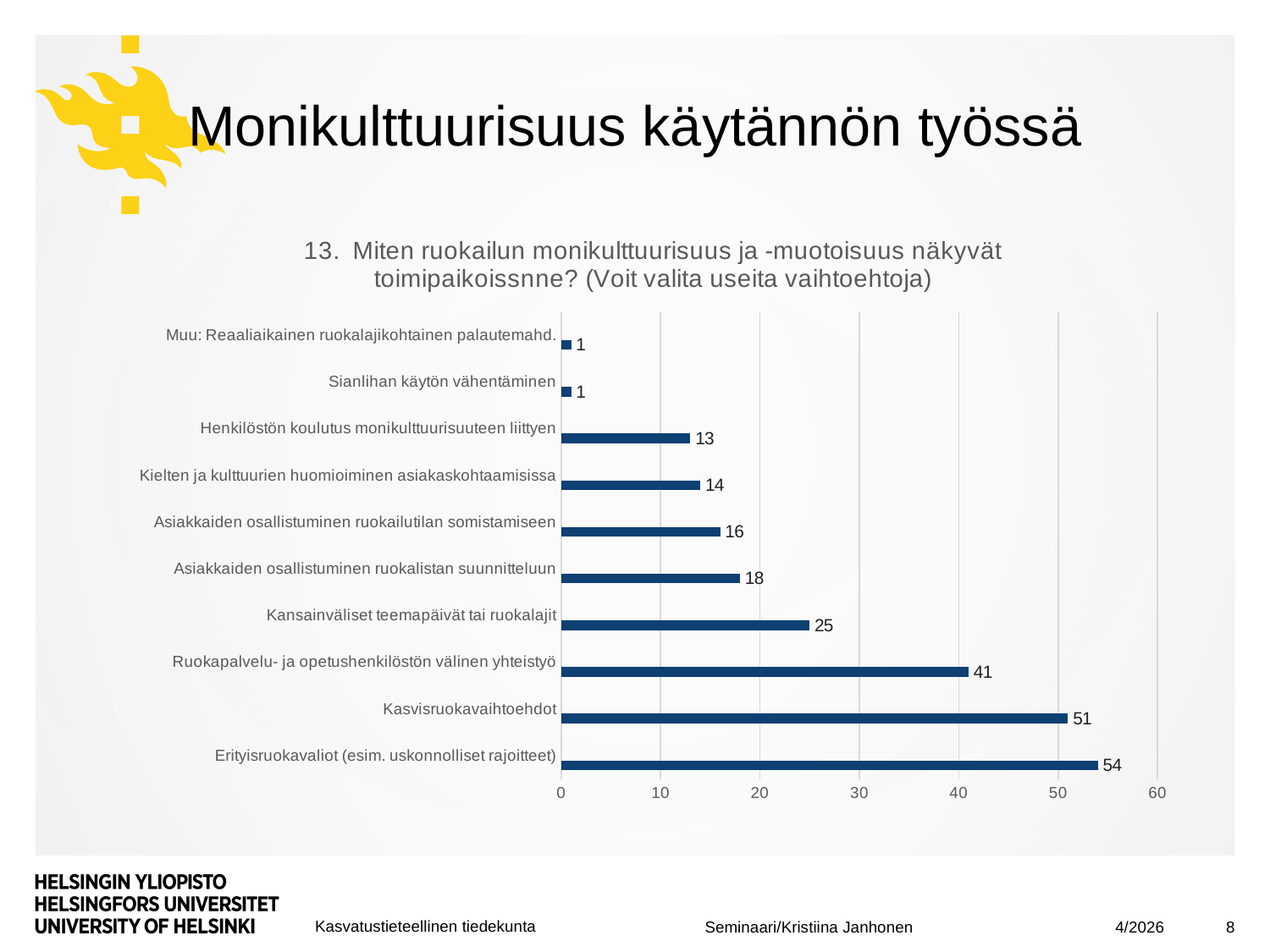
What is the difference between the values for Erityisruokavaliot (esim. uskonnolliset rajoitteet) and Kasvisruokavaihtoehdot? 3 Is the value for Asiakkaiden osallistuminen ruokalistan suunnitteluun greater or less than 20? less What kind of chart is shown on the slide? bar chart What is the value for Kasvisruokavaihtoehdot? 51 Which category has the highest value? Erityisruokavaliot (esim. uskonnolliset rajoitteet) What is the maximum value shown on the horizontal axis? 60 How many categories are shown in the chart? 10 What is the value for Henkilöstön koulutus monikulttuurisuuteen liittyen? 13 What is the value for Kansainväliset teemapäivät tai ruokalajit? 25 What is the value for Sianlihan käytön vähentäminen? 1 Which is larger: the value for Ruokapalvelu- ja opetushenkilöstön välinen yhteistyö or the value for Kansainväliset teemapäivät tai ruokalajit? Ruokapalvelu- ja opetushenkilöstön välinen yhteistyö What is the difference between the values for Asiakkaiden osallistuminen ruokalistan suunnitteluun and Asiakkaiden osallistuminen ruokailutilan somistamiseen? 2